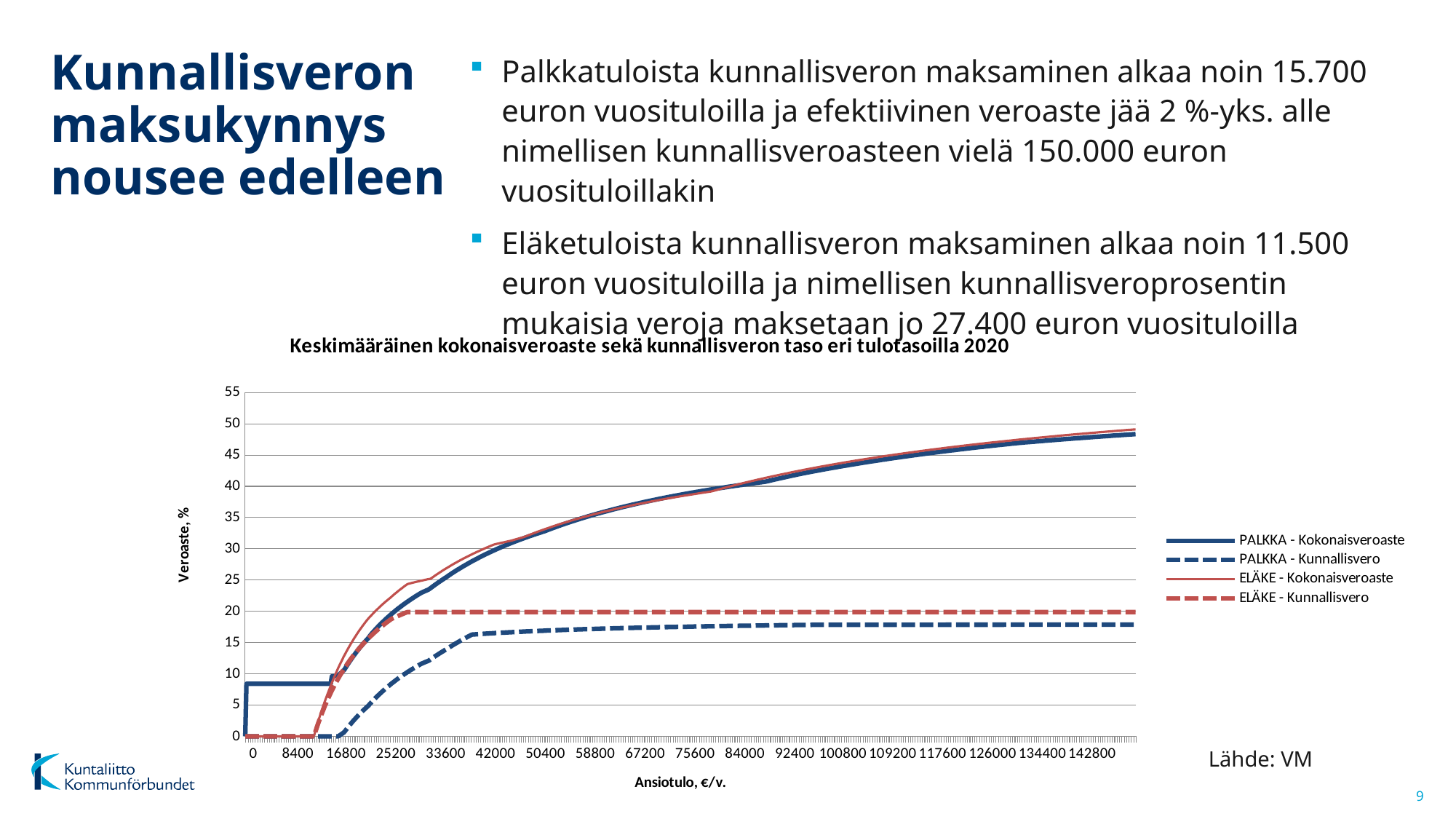
Is the value of PALKKA - Kokonaisveroaste at 142800 greater or less than 50? less Is the value of PALKKA - Kunnallisvero at 142800 greater or less than 15? greater At an Ansiotulo of 25200, which is larger: ELÄKE - Kunnallisvero or PALKKA - Kunnallisvero? ELÄKE - Kunnallisvero What kind of chart is shown on the slide? line chart At an Ansiotulo of 142800, which is larger: ELÄKE - Kunnallisvero or PALKKA - Kunnallisvero? ELÄKE - Kunnallisvero Is the value of ELÄKE - Kokonaisveroaste at 33600 greater or less than 20? greater Does the PALKKA - Kokonaisveroaste line rise or fall as Ansiotulo increases from 16800 to 142800? rise What is the title of the chart? Keskimääräinen kokonaisveroaste sekä kunnallisveron taso eri tulotasoilla 2020 How many series does the chart legend list? 4 What is the label of the vertical axis of the chart? Veroaste, %